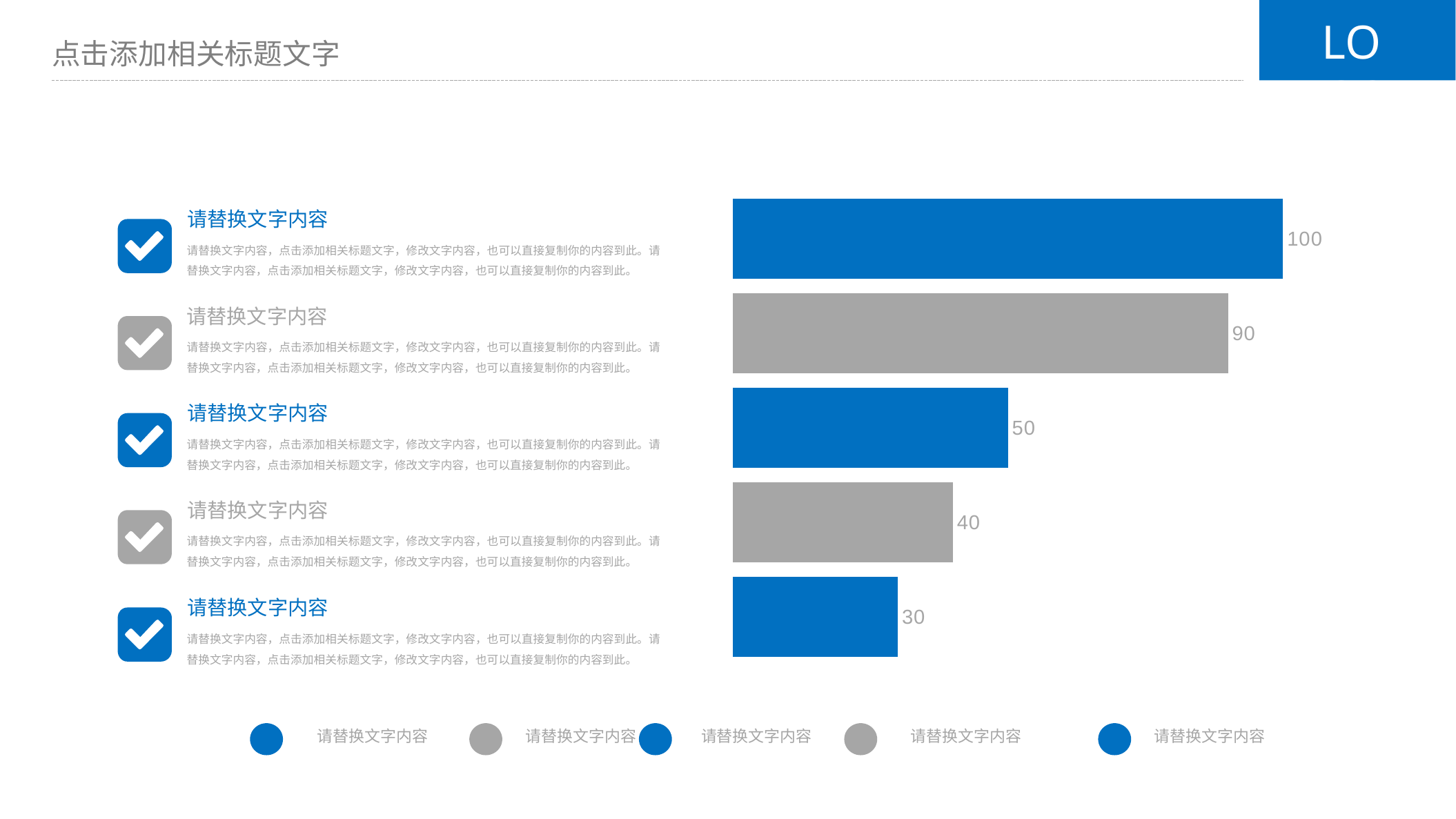
What is the value of the bottom bar in the chart? 30 What is the lowest value shown in the chart? 30 What type of chart is shown on the slide? bar chart What is the value of the second bar from the top? 90 What is the value of the middle (third) bar? 50 How many entries does the legend at the bottom of the slide list? 5 Which is larger, the value of the third bar or the value of the fourth bar? the third bar (50) What is the difference between the top bar's value and the bottom bar's value? 70 Do the bar values increase or decrease going from the top bar to the bottom bar? decrease What is the value of the top bar in the chart? 100 What is the highest value shown in the chart? 100 How many bars does the chart contain? 5